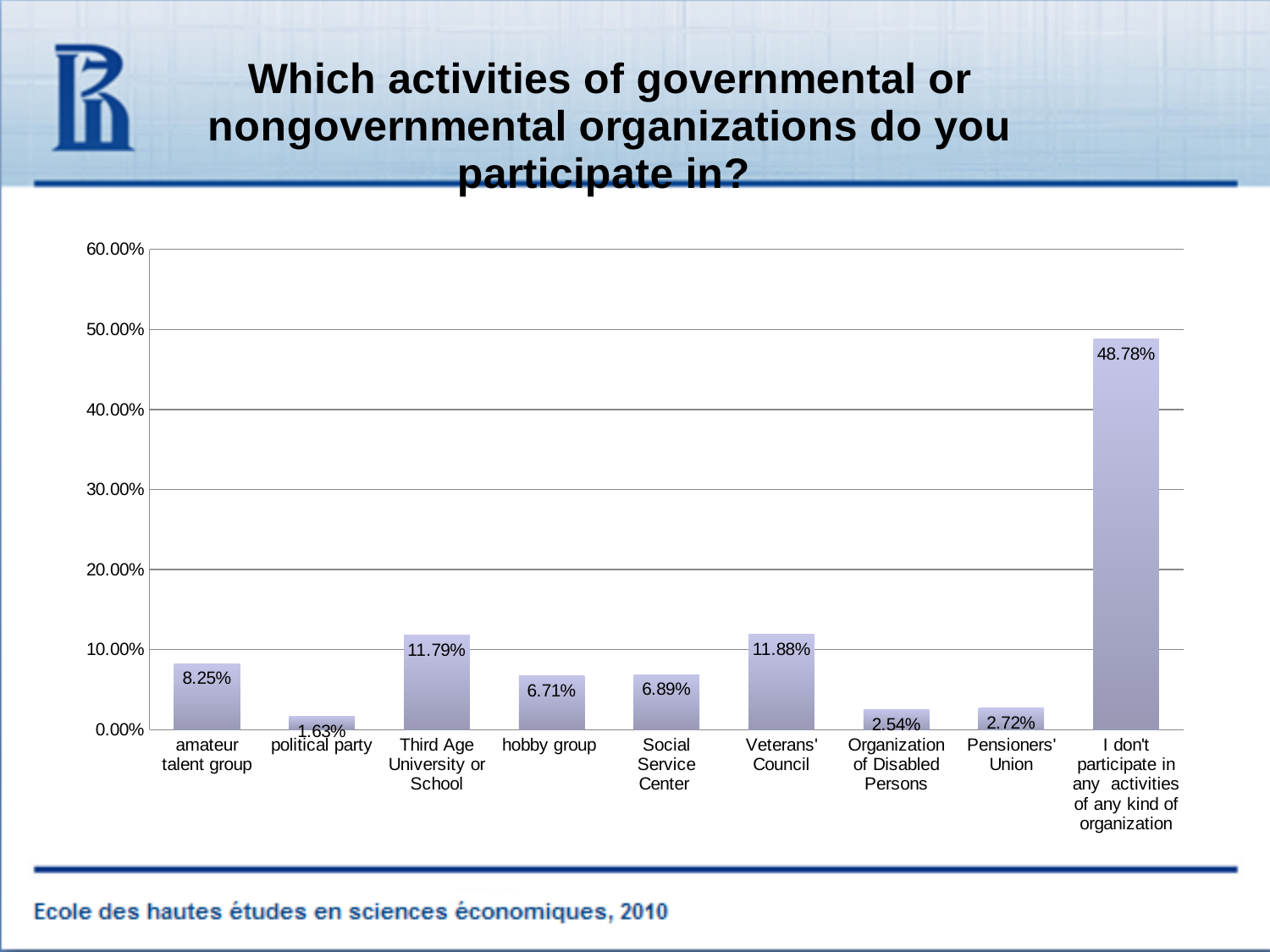
What is the difference between the values for Third Age University or School and hobby group? 5.08% How many categories are shown on the x axis? 9 Which category has the lowest value? political party What kind of chart is shown on the slide? bar chart What is the value shown for Pensioners' Union? 2.72% Which is larger, the value for Social Service Center or the value for amateur talent group? amateur talent group What percentage of respondents participate in an amateur talent group? 8.25% Is the value for Veterans' Council greater or less than 10.00%? greater What is the highest value labelled on the y axis? 60.00% Which category has the highest value? I don't participate in any activities of any kind of organization What percentage of respondents say they don't participate in any activities of any kind of organization? 48.78% What is the value shown for Veterans' Council? 11.88%